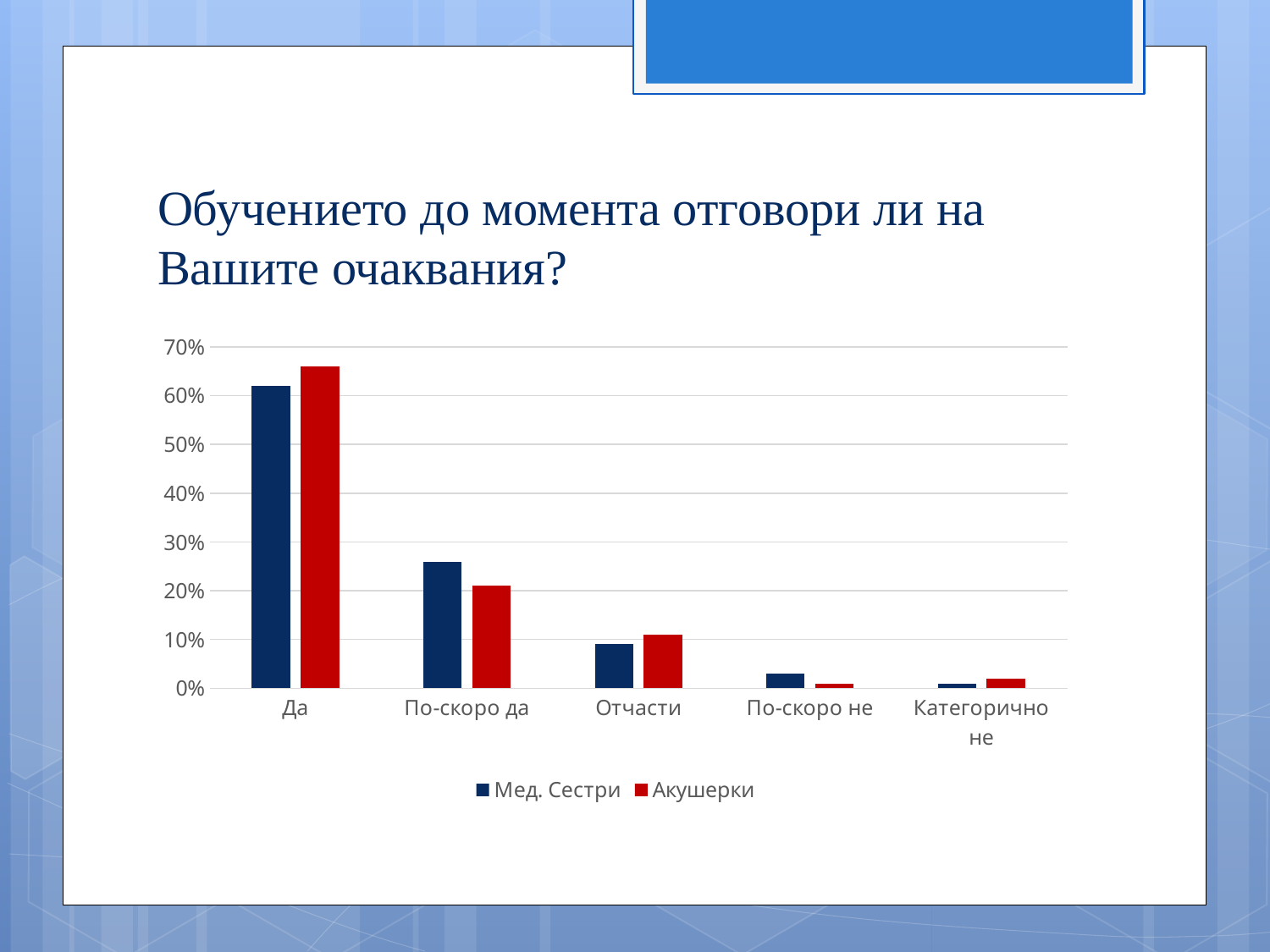
Which category has the highest value for Акушерки? Да What kind of chart is shown on the slide? bar chart Which category has the highest value for Мед. Сестри? Да In the Да category, which series has the larger value, Мед. Сестри or Акушерки? Акушерки What colour are the bars for the Акушерки series? red How many categories are shown on the x axis of the chart? 5 Is the value for Акушерки in the По-скоро да category greater or less than 30%? less Is the value for Мед. Сестри in the Да category greater or less than 50%? greater Do the values for Мед. Сестри generally rise or fall from left to right along the x axis? fall Is the value for Мед. Сестри in the Отчасти category greater or less than 20%? less How many series does the chart's legend list? 2 In the По-скоро да category, which series has the larger value, Мед. Сестри or Акушерки? Мед. Сестри